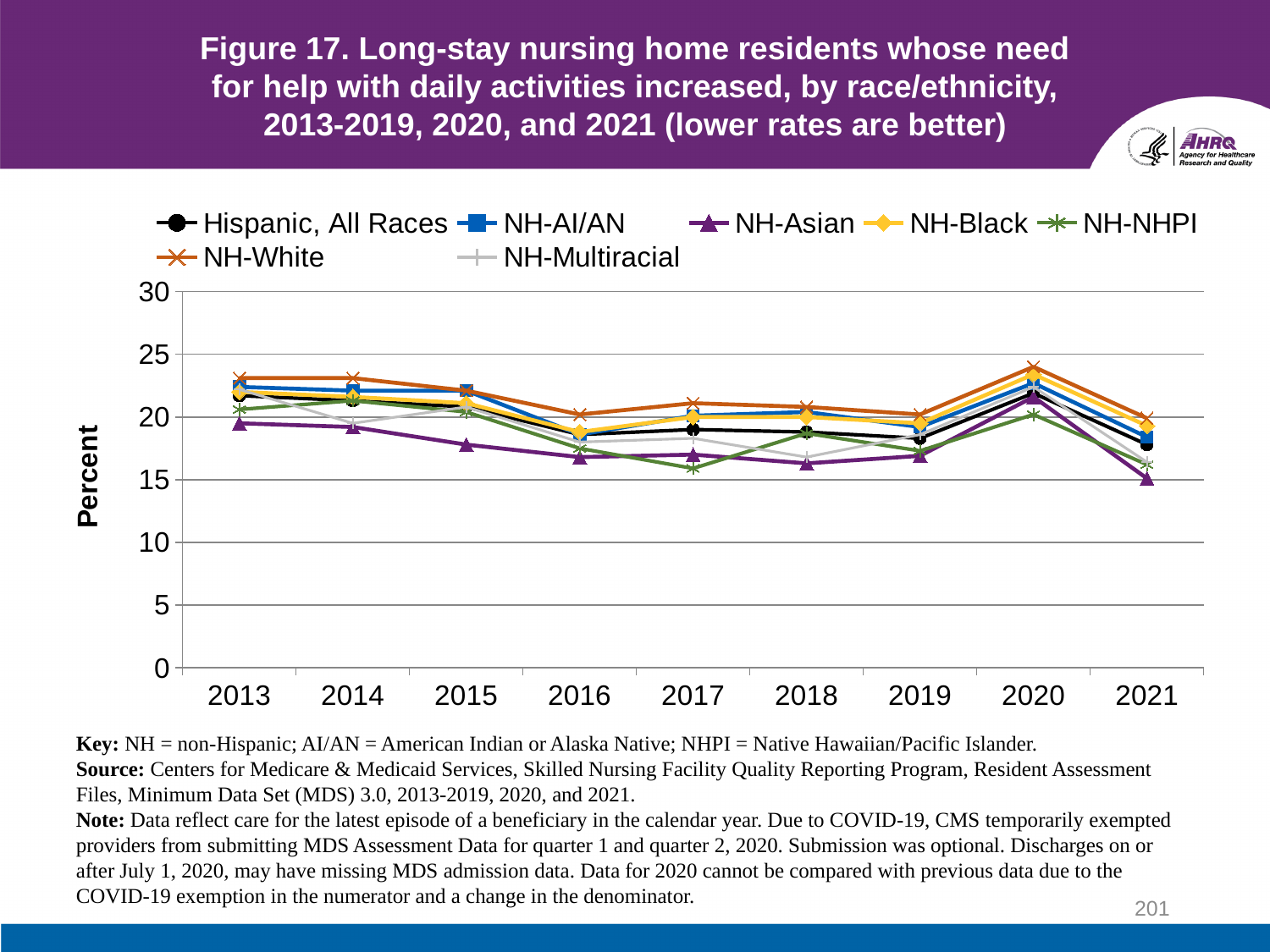
What kind of chart is shown on the slide? line chart Which race/ethnicity group has the lowest value in 2013? NH-Asian What is the label on the y axis? Percent Is the value for NH-White in 2020 greater or less than 25? less How many years are shown along the x axis? 9 Which race/ethnicity group has the highest value in 2020? NH-White Is the value for NH-Asian in 2021 greater or less than 20? less In 2013, which is larger: the value for NH-White or the value for NH-Asian? NH-White How many series does the legend list? 7 Which race/ethnicity group has the lowest value in 2021? NH-Asian Does the value for NH-White rise or fall from 2020 to 2021? fall Is the value for NH-White in 2020 greater or less than 20? greater